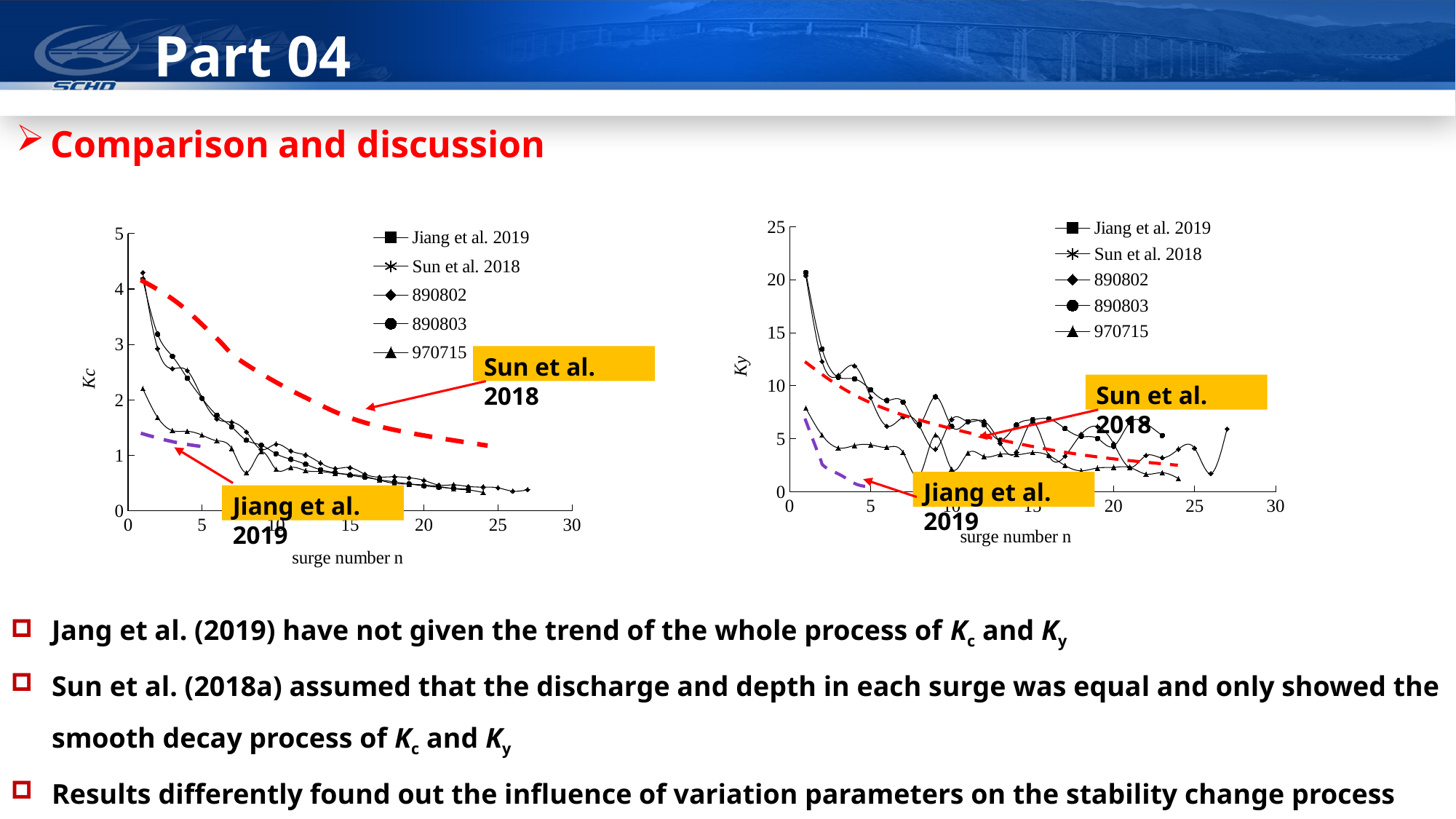
In the right chart (Ky), is the value of 890803 at surge number 1 greater or less than 20? greater In the left chart (Kc), at surge number 1, which is larger: 890802 or 970715? 890802 In the right chart (Ky), is the value of Sun et al. 2018 at surge number 1 greater or less than 10? greater How many series does the legend of the right chart (Ky vs surge number n) list? 5 In the left chart (Kc), is the value of Jiang et al. 2019 at surge number 1 greater or less than 2? less In the left chart (Kc), does the Sun et al. 2018 curve rise or fall as surge number n increases? fall What kind of chart is the left chart (Kc vs surge number n)? line chart In the right chart (Ky), what is the highest value shown on the y axis? 25 In the left chart (Kc), what is the label of the x axis? surge number n In the right chart (Ky), does the Sun et al. 2018 curve rise or fall as surge number n increases? fall